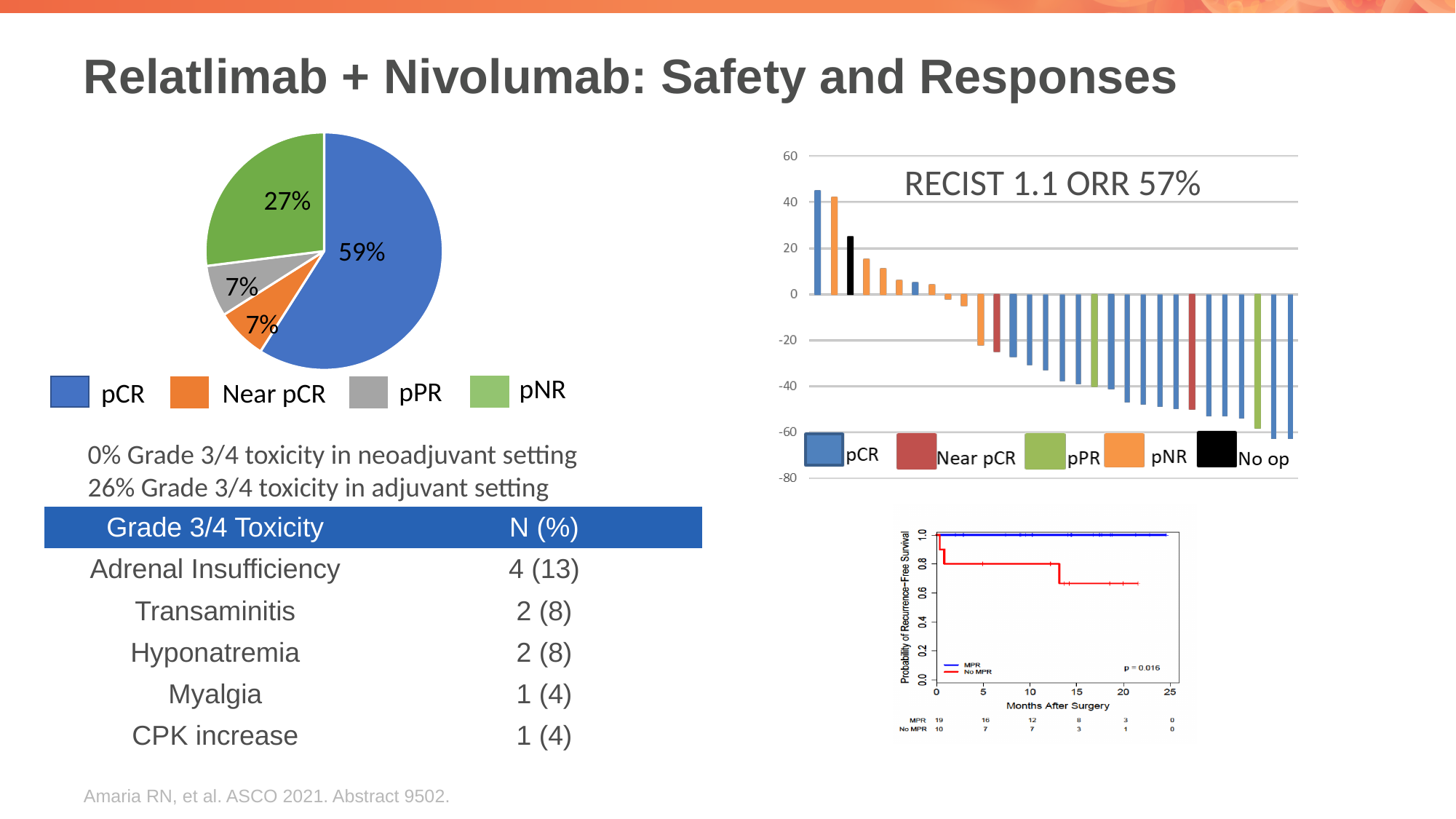
In the RECIST 1.1 ORR 57% chart, is the value of the first (leftmost) bar greater or less than 40? greater In the pie chart, what is the difference in percentage points between the pCR and pNR slices? 32% In the pie chart, what percentage of patients had pCR? 59% In the RECIST 1.1 ORR 57% chart, how many categories does the legend list? 5 In the pie chart, which category has the largest share? pCR In the pie chart, what percentage of patients had pNR? 27% What is the title shown on the bar chart at the top right of the slide? RECIST 1.1 ORR 57% In the survival curve chart at the bottom right, how many groups does the legend list? 2 What kind of chart is the chart at the top left of the slide? Pie chart In the pie chart, which is larger, the pNR slice or the pPR slice? pNR In the RECIST 1.1 ORR 57% chart, do the bar values rise or fall from left to right? fall In the pie chart, how many slices are there? 4